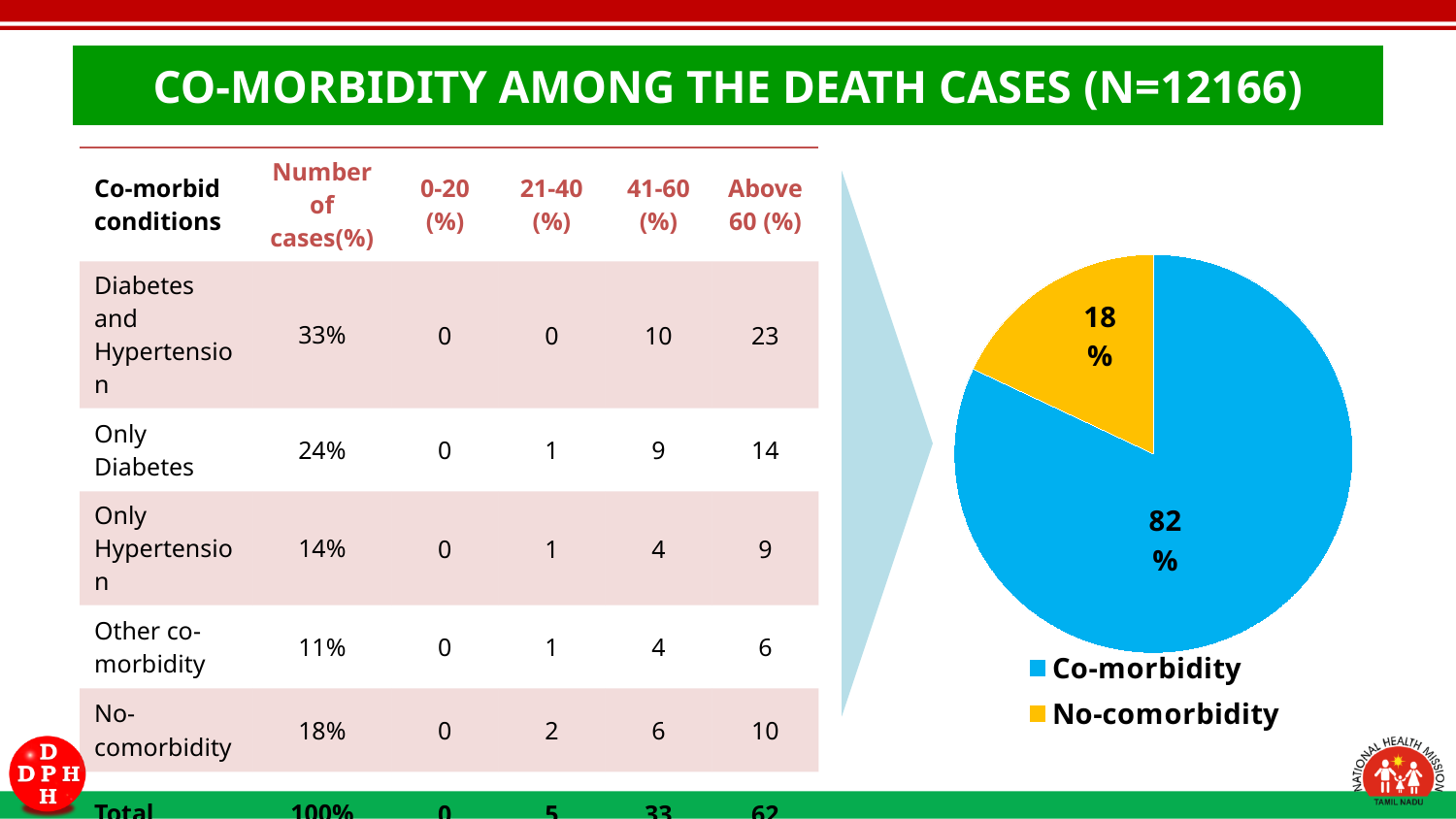
How many entries does the pie chart legend list? 2 What kind of chart is shown on the slide? pie chart How many slices does the pie chart have? 2 What is the total of the two slices shown in the pie chart? 100% Which slice of the pie chart is the smallest? No-comorbidity What colour is the No-comorbidity slice in the pie chart? yellow What colour is the Co-morbidity slice in the pie chart? blue What share of the pie does the Co-morbidity slice represent? 82% What share of the pie does the No-comorbidity slice represent? 18% Which slice of the pie chart is the largest? Co-morbidity Which is larger in the pie chart, Co-morbidity or No-comorbidity? Co-morbidity What is the difference in percentage points between the Co-morbidity and No-comorbidity slices? 64